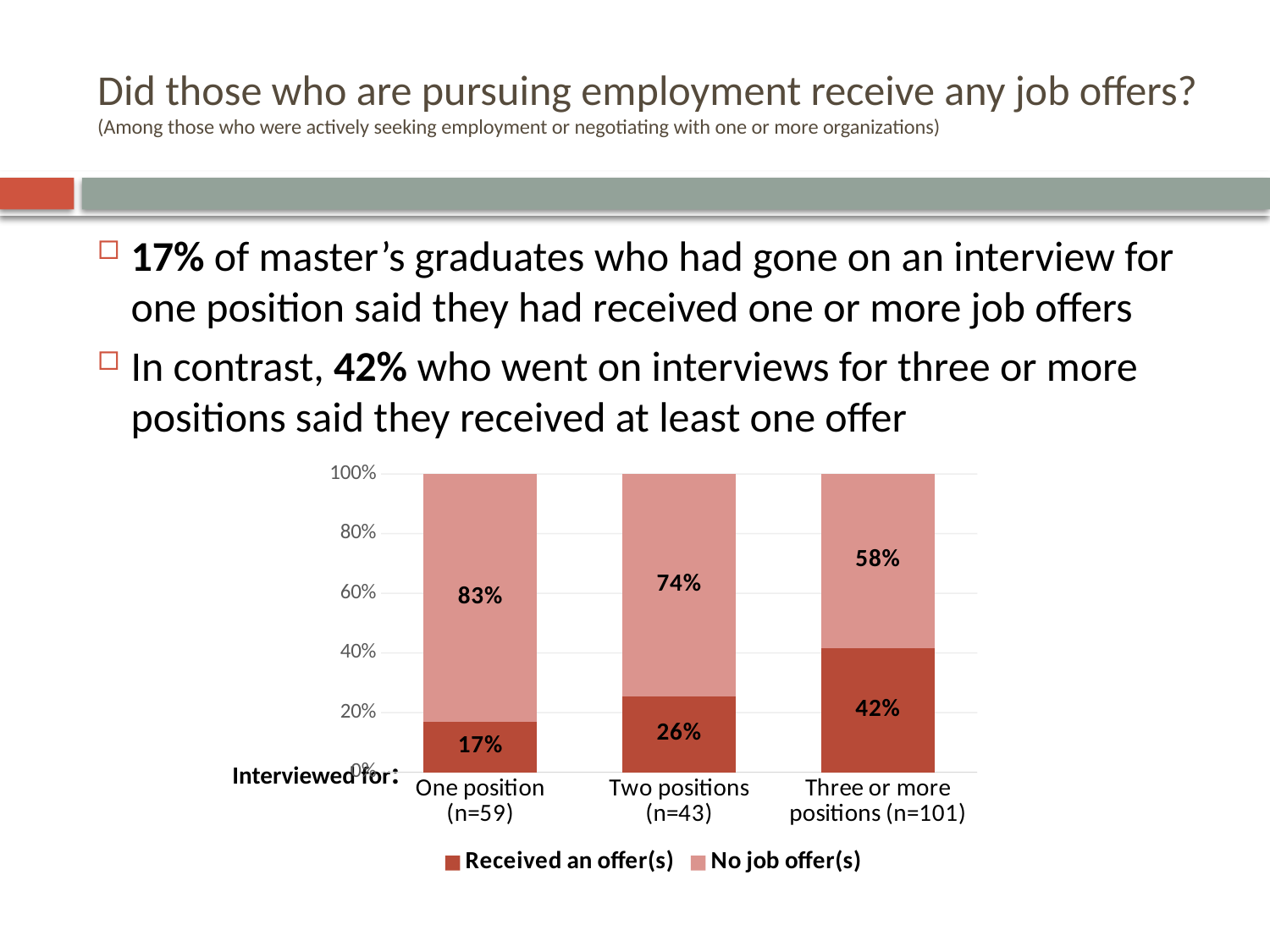
How many series does the legend list? 2 What percentage of those interviewed for three or more positions received an offer(s)? 42% What percentage of those interviewed for two positions had no job offer(s)? 74% Which category has the lowest share of 'No job offer(s)'? Three or more positions (n=101) What percentage of those interviewed for one position received an offer(s)? 17% What kind of chart is shown on the slide? Stacked bar chart How many categories are shown on the x axis? 3 Does the 'Received an offer(s)' share rise or fall from one position to three or more positions? Rise What is the difference between the 'Received an offer(s)' share for three or more positions and for one position? 25% Which category has the highest share of 'Received an offer(s)'? Three or more positions (n=101) What is the total of the stacked bar for two positions? 100% Is the 'No job offer(s)' share larger for one position or for two positions? One position